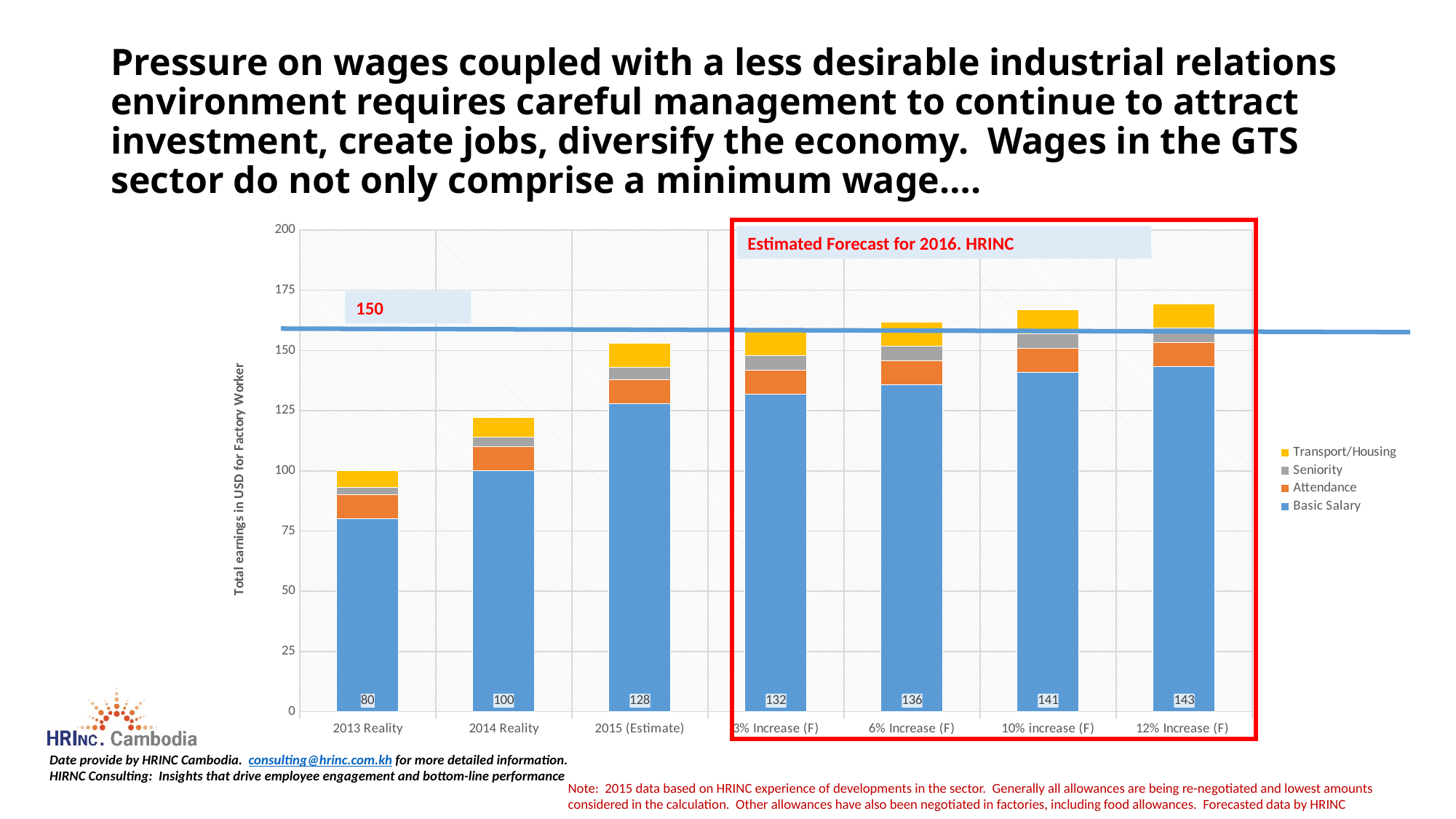
What kind of chart is shown on the slide? Stacked bar chart Is the total stacked value for 2014 Reality greater or less than 100? greater What is the difference in Basic Salary between 12% Increase (F) and 3% Increase (F)? 11 Which category has the highest Basic Salary value? 12% Increase (F) What is the Basic Salary value for 2015 (Estimate)? 128 Which has a larger Basic Salary value, 6% Increase (F) or 10% increase (F)? 10% increase (F) How many categories are shown on the x axis? 7 What is the Basic Salary value for 12% Increase (F)? 143 Which category has the lowest Basic Salary value? 2013 Reality How many series does the legend list? 4 What is the Basic Salary value for 2013 Reality? 80 What is the difference in Basic Salary between 2014 Reality and 2013 Reality? 20